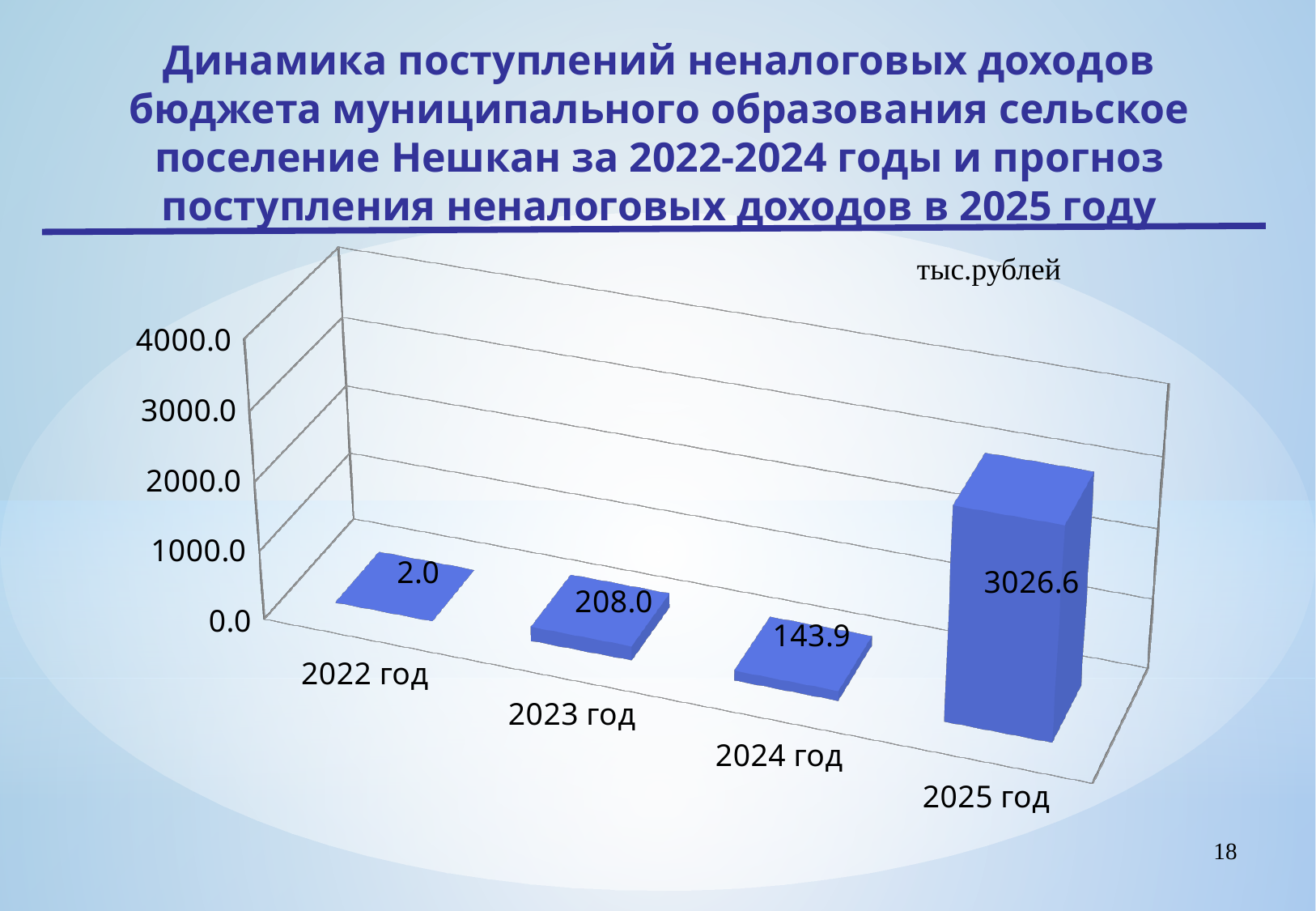
Which is larger, the value for 2023 год or 2024 год? 2023 год How many years are shown on the chart? 4 What is the difference between the values for 2023 год and 2024 год? 64.1 Which year has the lowest value? 2022 год What is the value for 2023 год? 208.0 What kind of chart is shown on the slide? bar chart Which year has the highest value? 2025 год What is the value for 2022 год? 2.0 What is the forecast value for 2025 год? 3026.6 What is the value for 2024 год? 143.9 Is the value for 2025 год greater or less than 3000.0? greater What unit of measurement is indicated on the chart? тыс.рублей